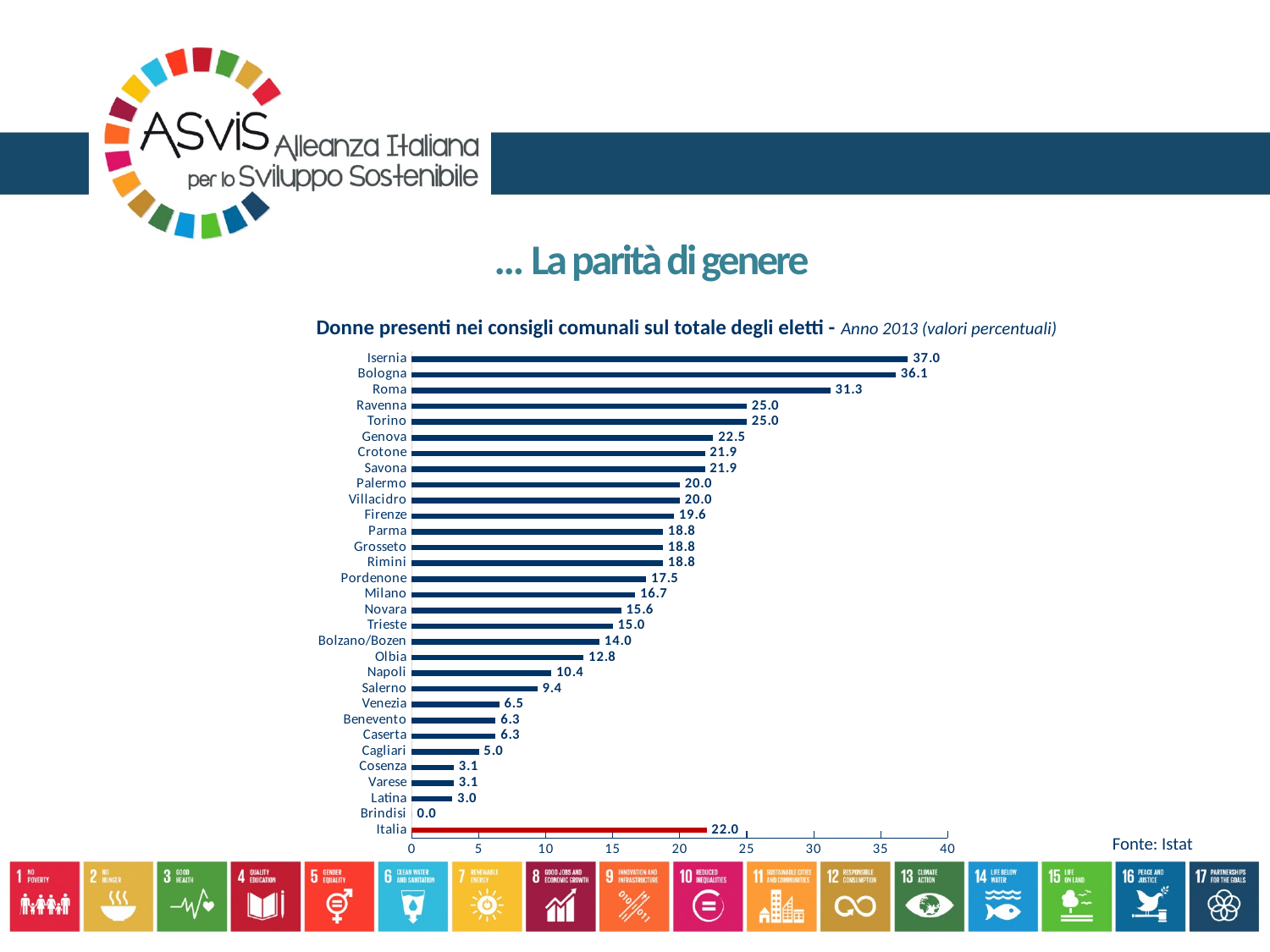
Which category has the highest value? Isernia What is the value for Bologna? 36.1 What is the difference between the values for Isernia and Roma? 5.7 How many bars are plotted in the chart? 31 Which category has the lowest value? Brindisi What kind of chart is shown on the slide? Bar chart Is the value for Genova greater or less than 20? greater Which has a larger value, Napoli or Salerno? Napoli What is the value shown for Italia? 22.0 What is the difference between the values for Italia and Venezia? 15.5 What is the value for Milano? 16.7 Which bar is drawn in red rather than dark blue? Italia